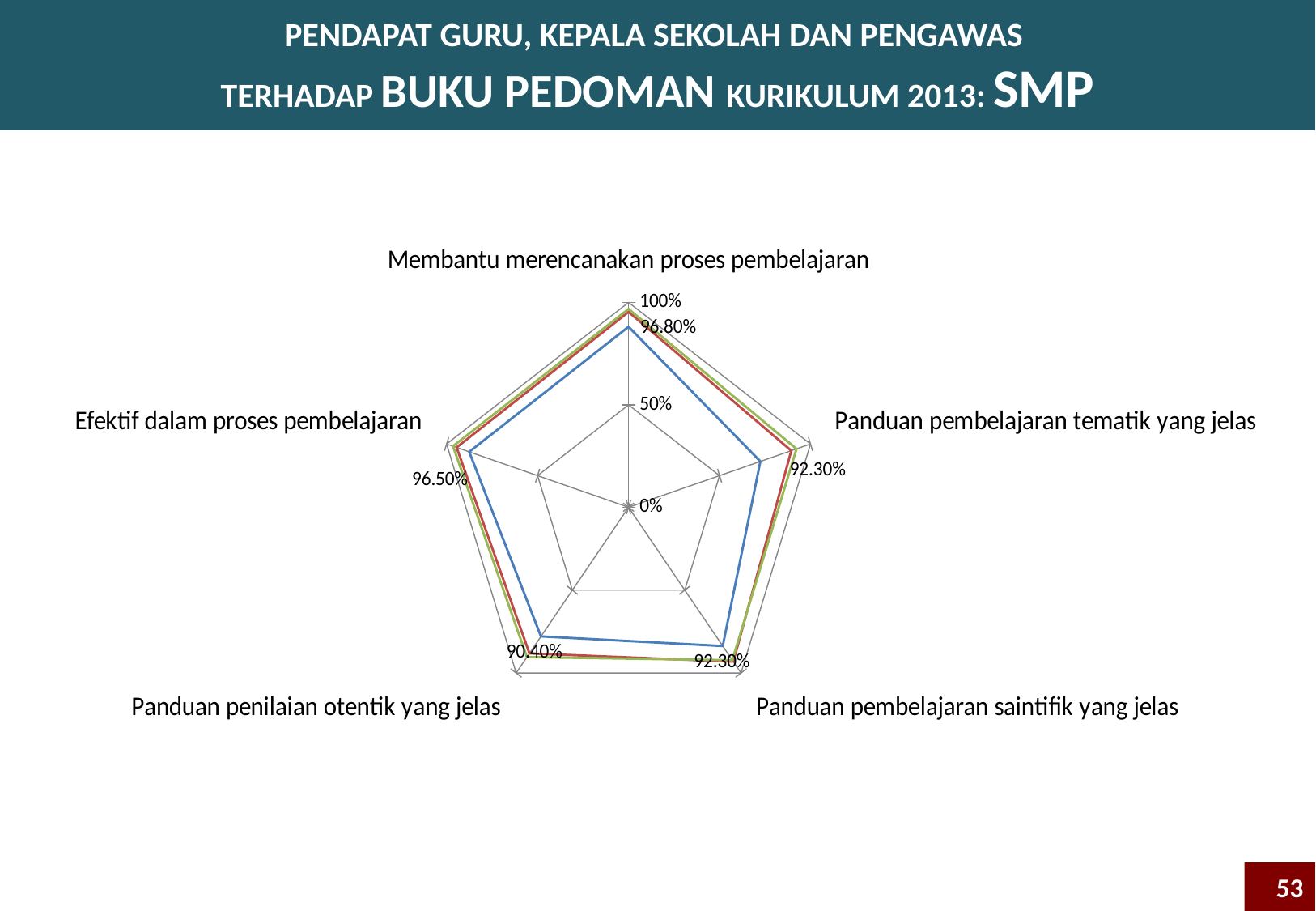
What type of chart is shown on the slide? Radar chart What is the maximum value shown on the radar chart's axis scale? 100% How many categories (axes) does the radar chart have? 5 Is the blue-line value for 'Panduan penilaian otentik yang jelas' greater or less than 50%? greater